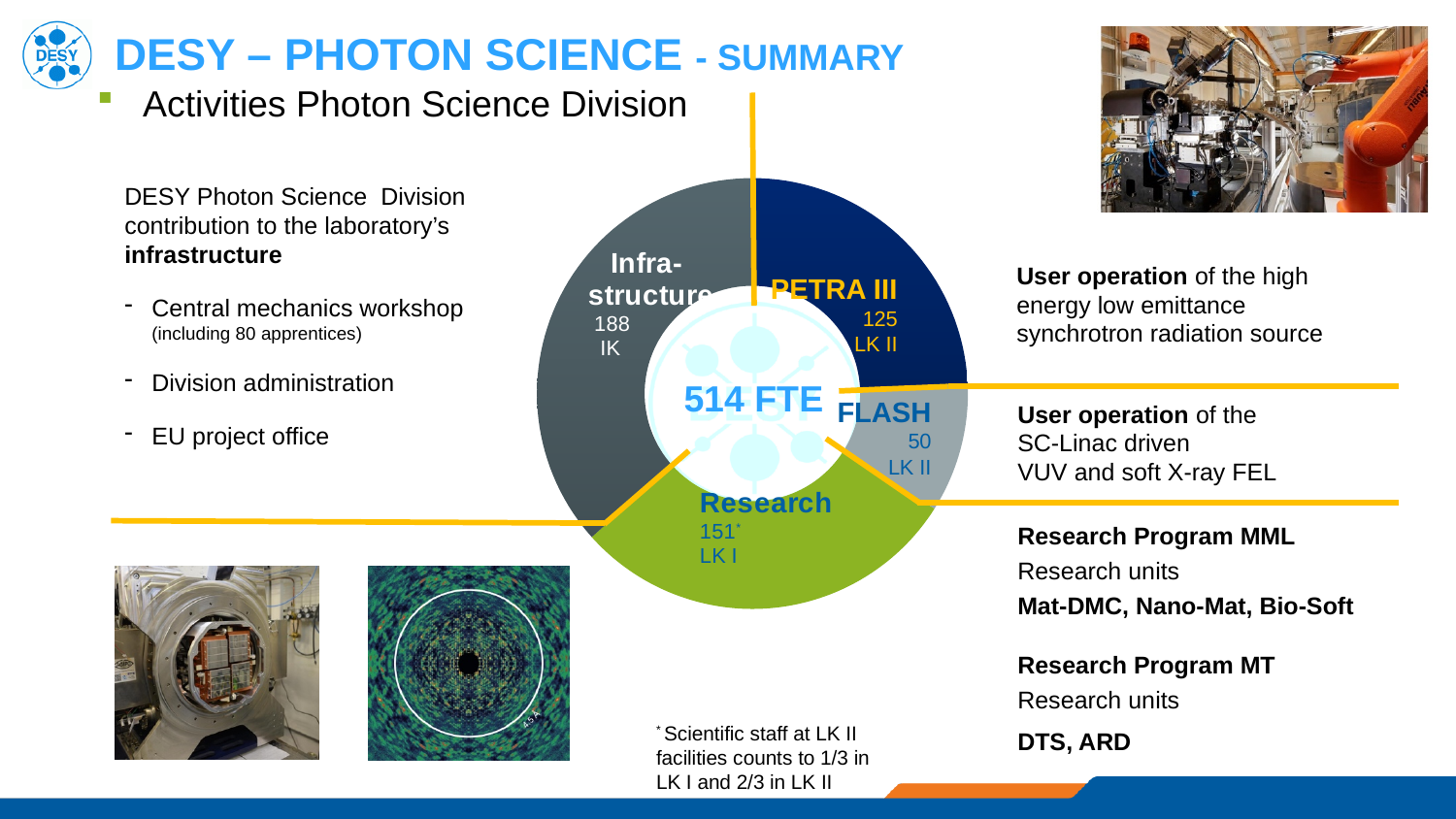
What value is shown for the Infrastructure segment of the donut chart? 188 What value is shown for the Research segment of the donut chart? 151 What value is shown for the PETRA III segment of the donut chart? 125 Which segment of the donut chart has the smallest value? FLASH What is the difference between the Infrastructure value and the Research value in the donut chart? 37 What value is shown for the FLASH segment of the donut chart? 50 Which category label is assigned to LK I in the donut chart? Research Which is larger in the donut chart, PETRA III or FLASH? PETRA III What kind of chart is shown in the centre of the slide? Pie (donut) chart Which segment of the donut chart has the largest value? Infrastructure What total is printed in the centre of the donut chart? 514 FTE How many segments does the donut chart have? 4